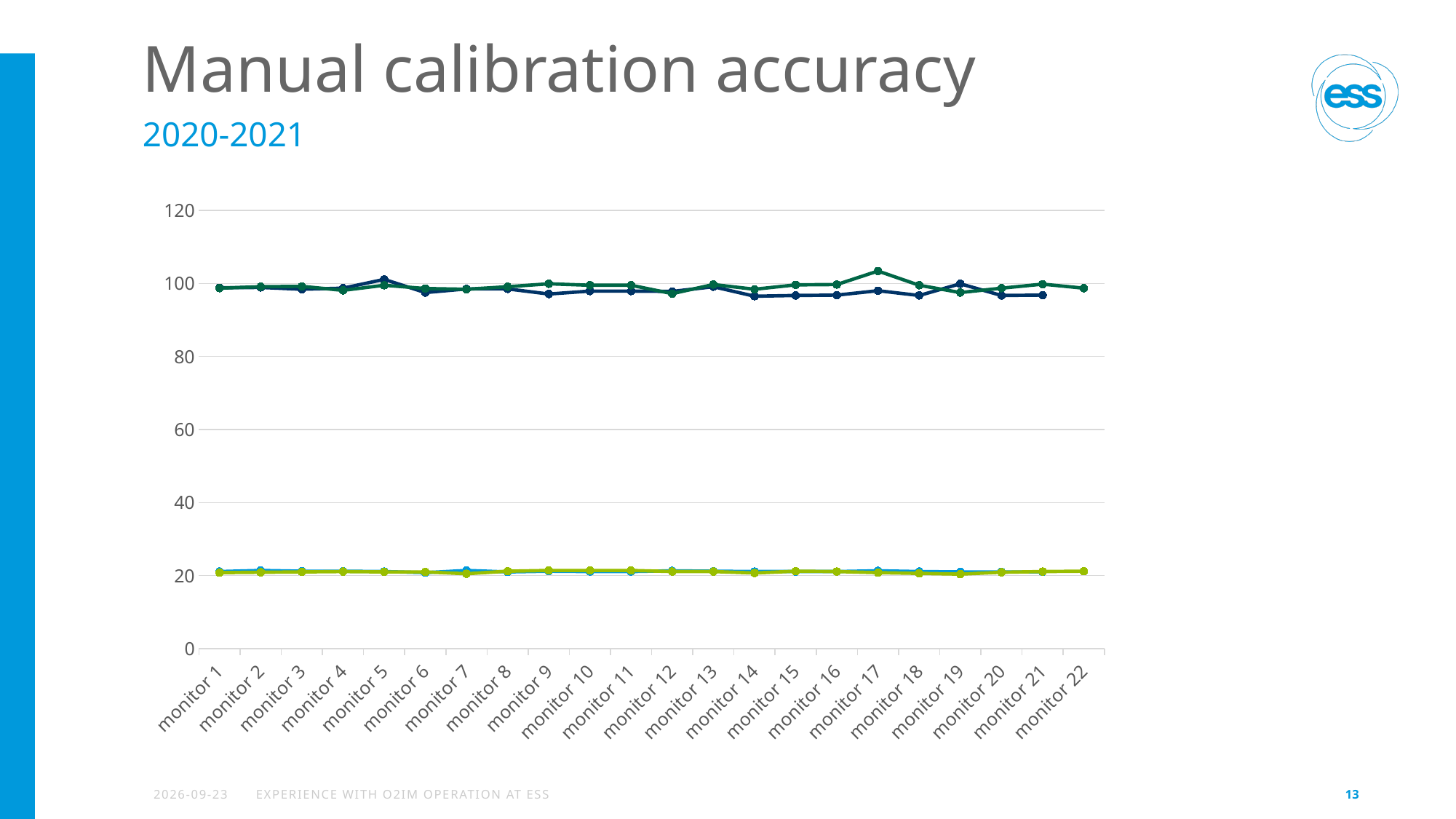
Is the value of the dark navy line at monitor 14 greater or less than 100? less Are the values of the lower two lines (light blue and lime green) greater or less than 40? less Are the values of the upper two lines (dark navy and green) greater or less than 80? greater What period does the subtitle under the chart title give? 2020-2021 Do the lines show a strong rising or falling trend from monitor 1 to monitor 22, or do they stay roughly flat? roughly flat At which monitor does the green line reach its highest value? monitor 17 At monitor 17, which line is higher: the green line or the dark navy line? the green line What is the title of the chart slide? Manual calibration accuracy What kind of chart is shown on the slide? line chart How many monitors are plotted along the x axis? 22